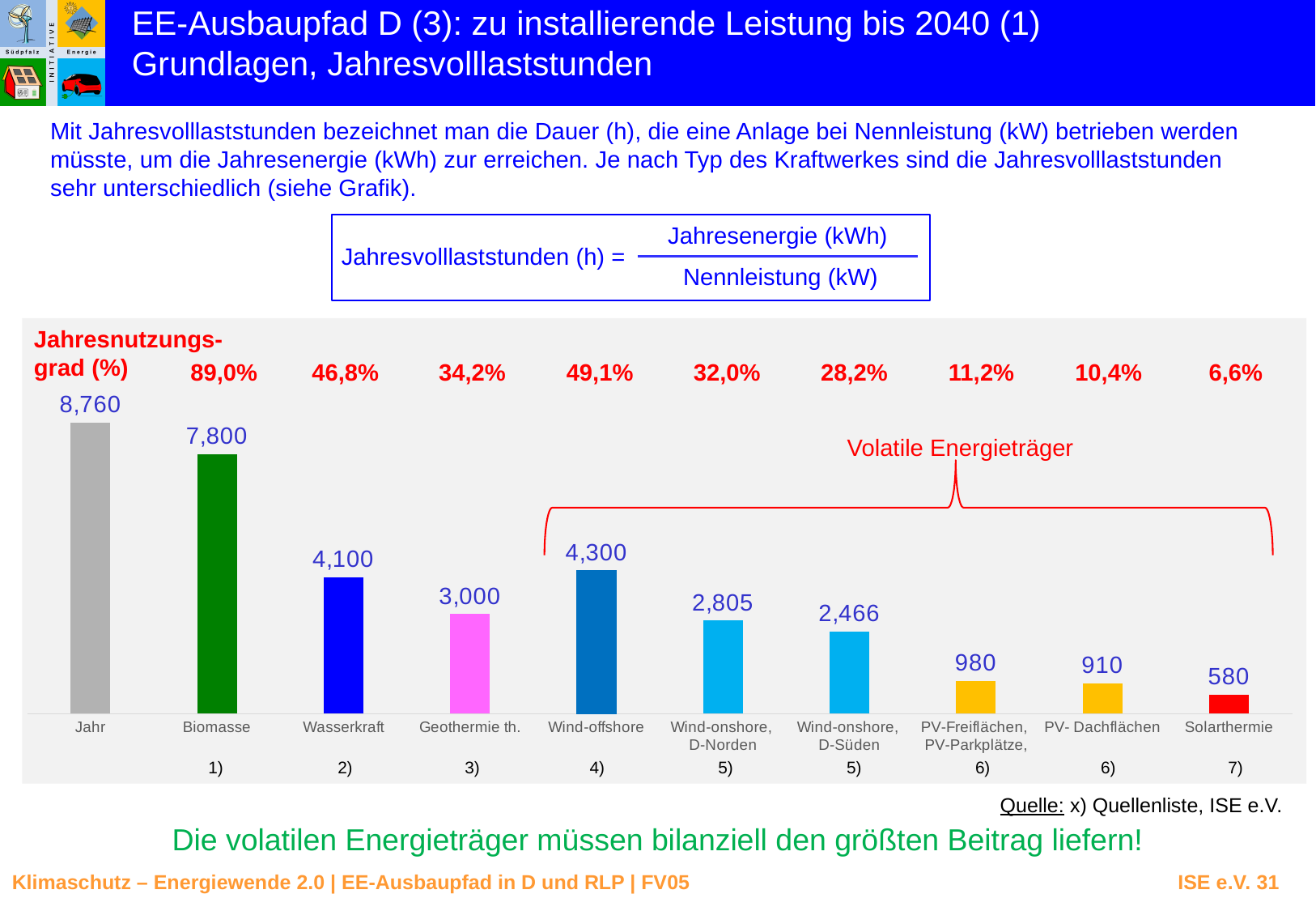
What is the value shown for Wind-onshore, D-Süden? 2,466 What is the value shown for Solarthermie? 580 What label is written above the red bracket spanning the right-hand bars? Volatile Energieträger Which category has the lowest bar? Solarthermie How many bars are shown in the chart? 10 What is the difference between the values for Wasserkraft and Geothermie th.? 1,100 What kind of chart is shown on the slide? Bar chart Which is larger, the value for Wind-offshore or the value for Wasserkraft? Wind-offshore What is the value shown for Wind-offshore? 4,300 What Jahresnutzungsgrad (%) is shown above the Biomasse bar? 89,0% Which category has the highest bar? Jahr What is the value shown for Biomasse? 7,800